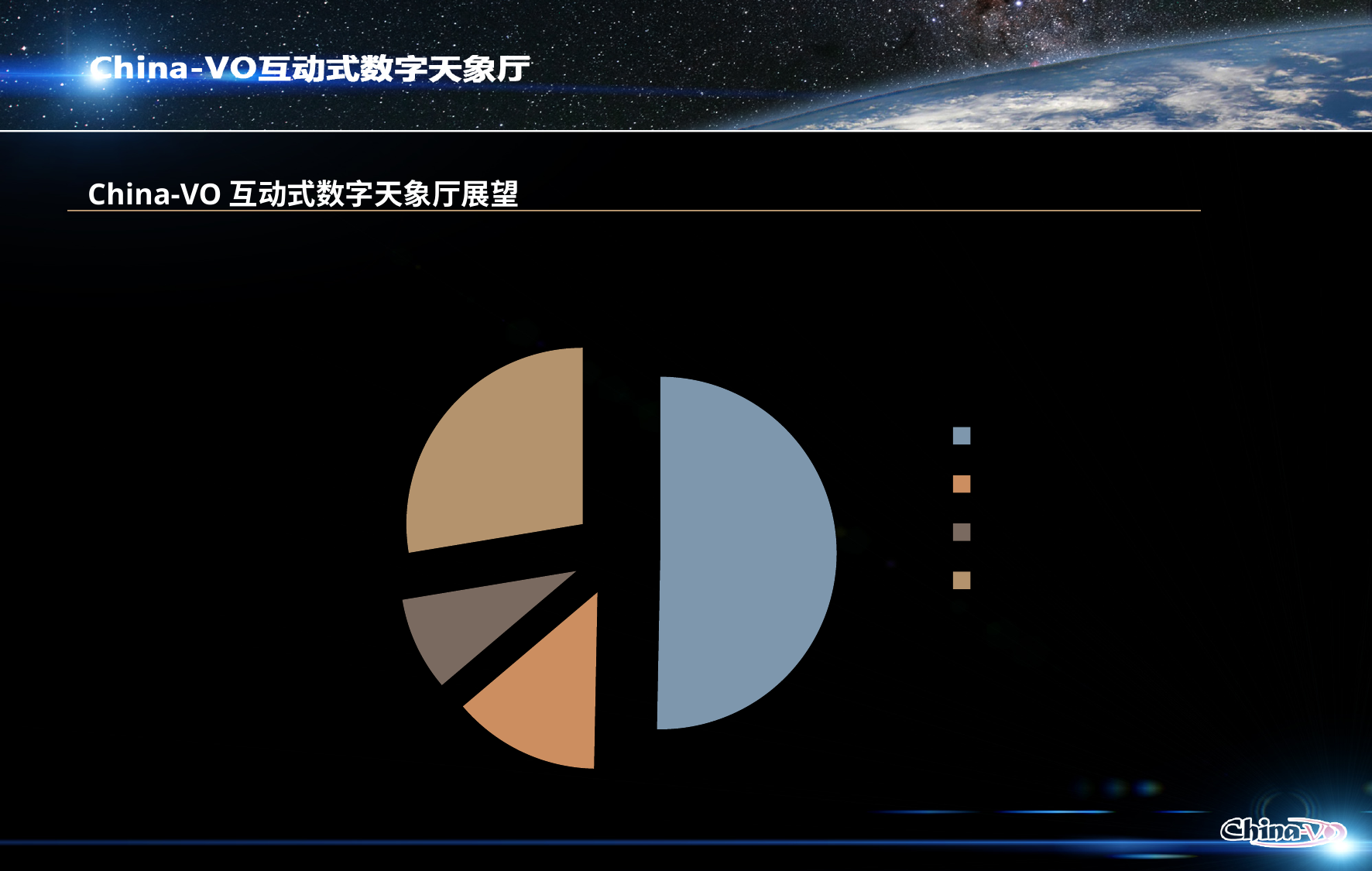
On which side of the pie chart is the legend placed? right What colour is the largest slice of the pie chart? blue Is the blue slice of the pie chart larger or smaller than the gray slice? larger How many entries does the legend of the pie chart list? 4 What kind of chart is shown on the slide? pie chart How many slices does the pie chart have? 4 Which slice of the pie chart is the second largest? the tan slice Is the tan slice of the pie chart larger or smaller than the orange slice? larger Is the blue slice of the pie chart larger or smaller than the tan slice? larger Which slice of the pie chart is the largest? the blue slice